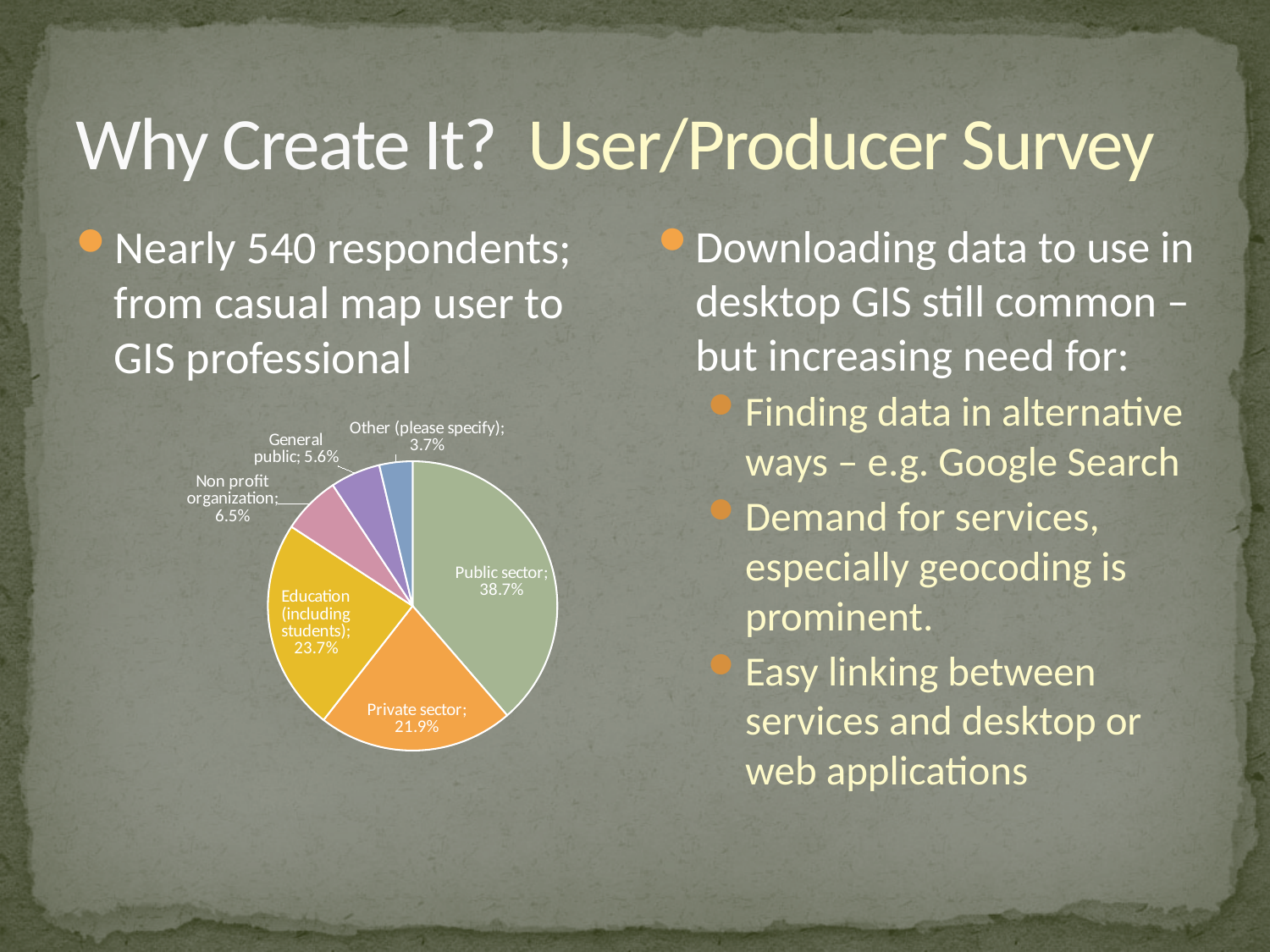
Which is larger, the Education (including students) slice or the Private sector slice? Education (including students) How many slices does the pie chart have? 6 What share of the pie does Private sector have? 21.9% What share of the pie does General public have? 5.6% Which category has the smallest slice of the pie? Other (please specify) What share of the pie does Non profit organization have? 6.5% What share of the pie does Public sector have? 38.7% What kind of chart is shown on the slide? pie chart What is the difference in percentage points between Public sector and Private sector? 16.8 Which category has the largest slice of the pie? Public sector What share of the pie does Education (including students) have? 23.7% What share of the pie does Other (please specify) have? 3.7%